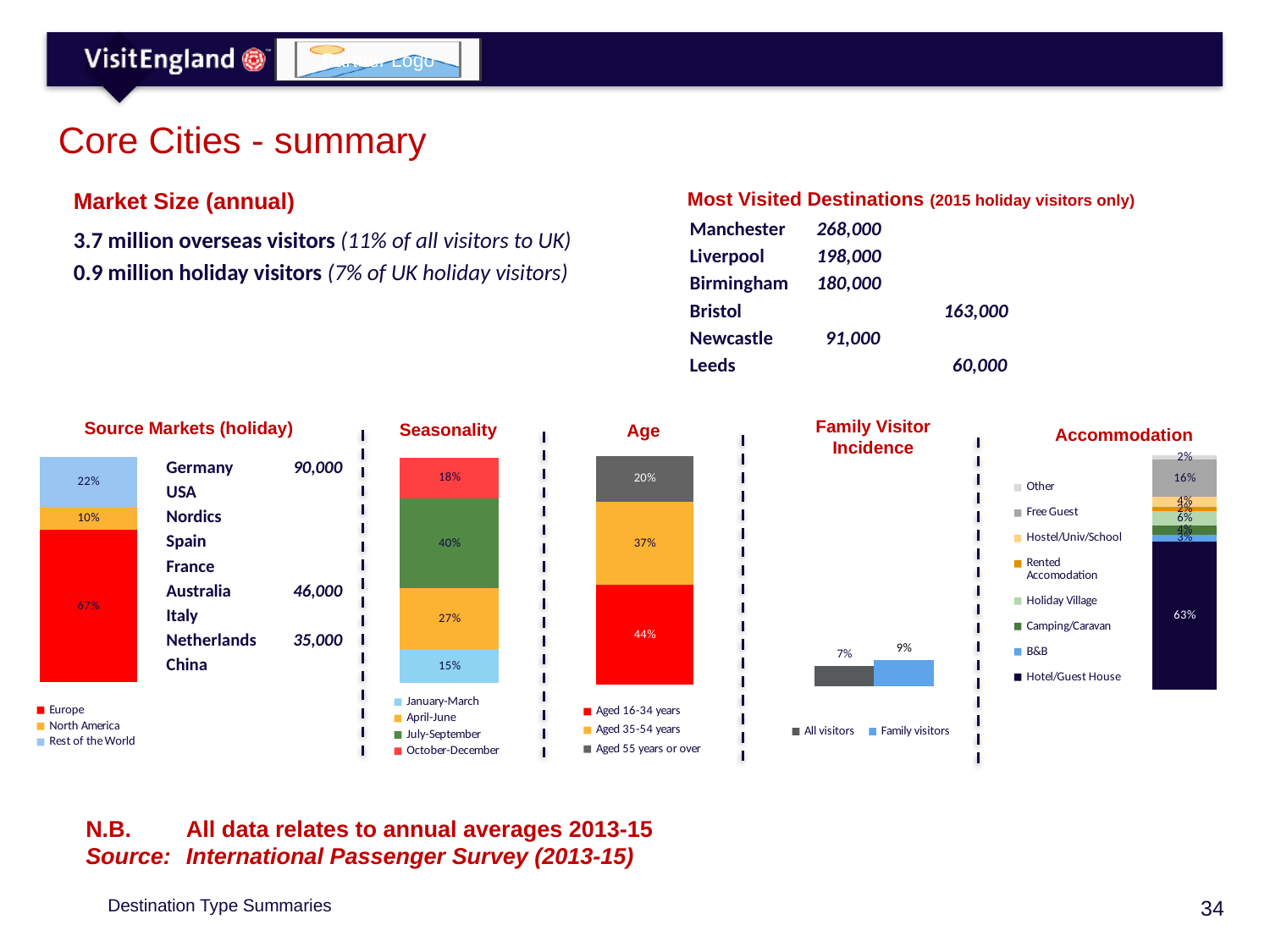
In the Seasonality chart, what is the difference between the July-September and April-June shares? 13% In the Source Markets (holiday) chart, what share is shown for Rest of the World? 22% In the Age chart, what share of visitors are aged 16-34 years? 44% In the Family Visitor Incidence chart, which is larger: All visitors or Family visitors? Family visitors In the Seasonality chart, which quarter has the lowest share of visits? January-March In the Age chart, which age group has the smallest share? Aged 55 years or over In the Seasonality chart, what percentage of visits occur in July-September? 40% In the Family Visitor Incidence chart, what is the value for Family visitors? 9% In the Source Markets (holiday) chart, which region has the smallest share? North America In the Accommodation chart, what share of visitors stay in a Hotel/Guest House? 63% In the Source Markets (holiday) chart, what share of holiday visitors comes from Europe? 67% How many series does the legend of the Accommodation chart list? 8